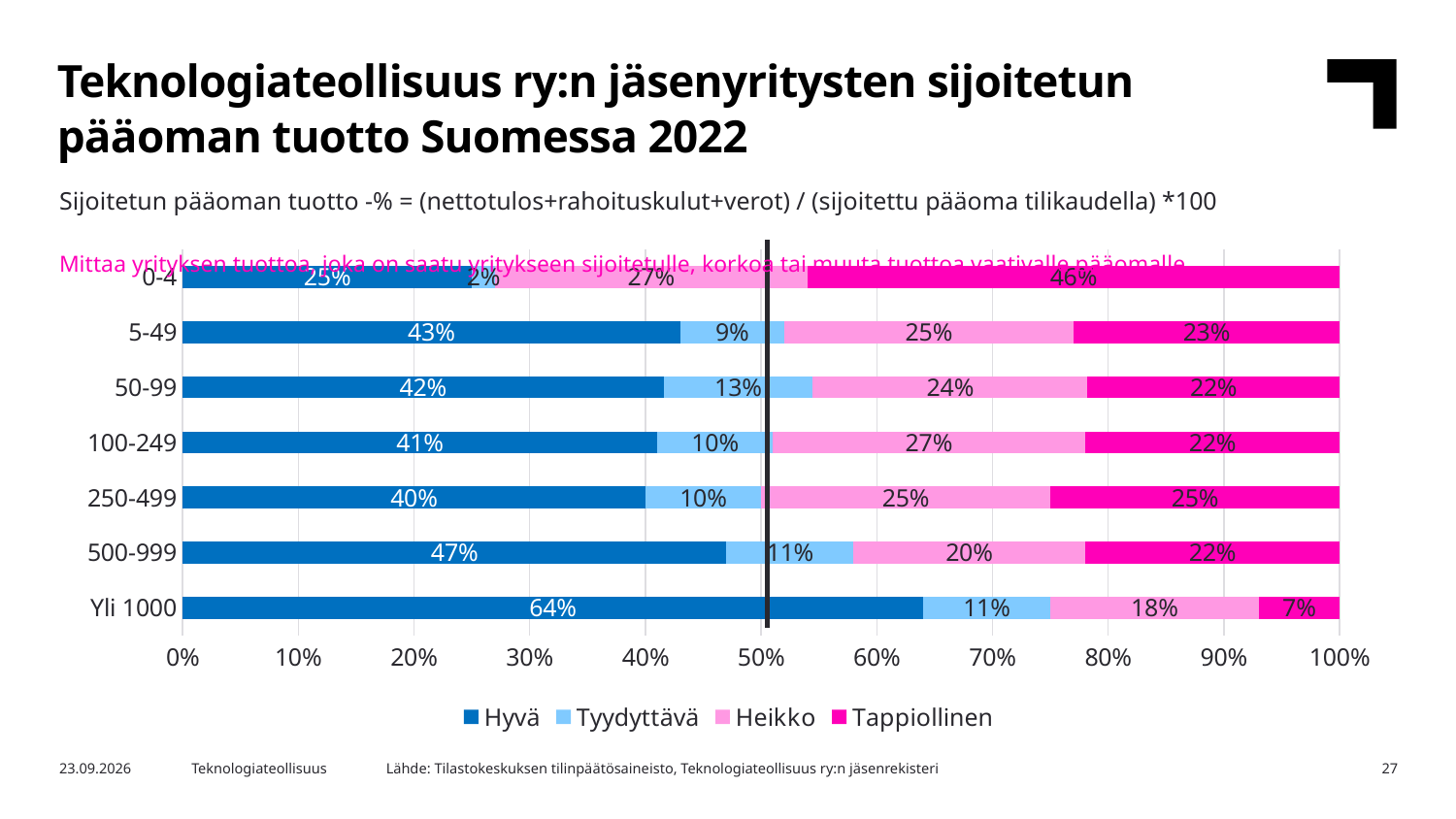
How many series does the legend list? 4 What is the Hyvä share for the Yli 1000 category? 64% What is the difference between the Hyvä share of Yli 1000 and the Hyvä share of 500-999? 17 percentage points What is the Tappiollinen share for the 0-4 category? 46% Which category has the lowest Tappiollinen share? Yli 1000 Which is larger: the Tappiollinen share for 250-499 or for 100-249? 250-499 Which category has the highest Hyvä share? Yli 1000 What is the Heikko share for the 500-999 category? 20% How many company size categories are shown on the chart? 7 What kind of chart is shown on the slide? Stacked bar chart Which series is shown in the darkest blue colour in the legend? Hyvä What is the Tyydyttävä share for the 50-99 category? 13%